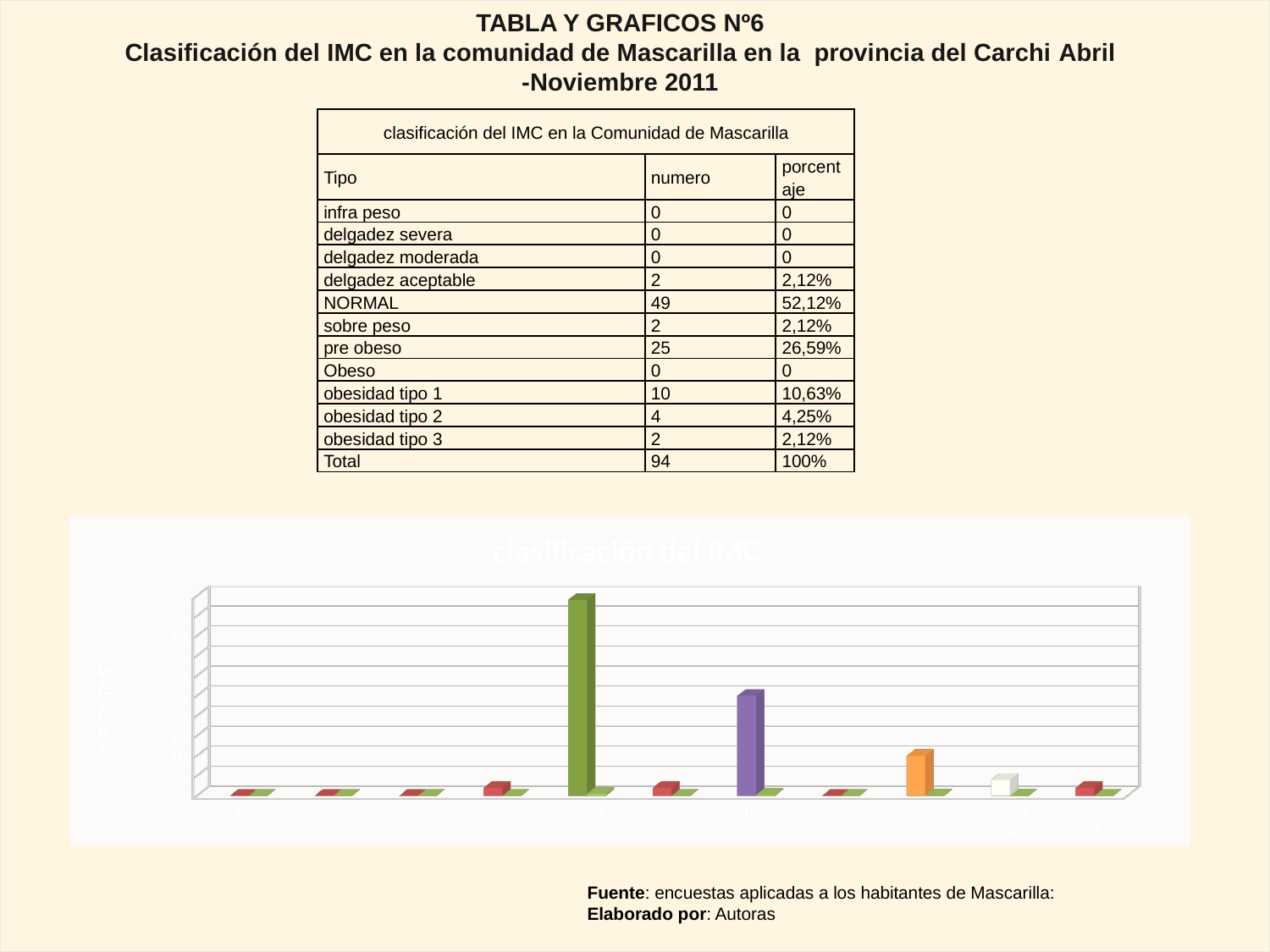
Which bar is taller in the chart, obesidad tipo 1 or obesidad tipo 2? obesidad tipo 1 Do the bars in the chart rise steadily, fall steadily, or fluctuate from left to right along the x axis? fluctuate How many categories are plotted along the x axis of the chart? 11 What colour is the tallest bar in the chart? green Which category has the tallest bar in the chart? NORMAL How many categories in the chart have a bar of essentially zero height? 4 Which bar is taller in the chart, pre obeso or obesidad tipo 1? pre obeso What is the title of the chart? clasificación del IMC What kind of chart is shown on the slide? bar chart Which bar is taller in the chart, NORMAL or pre obeso? NORMAL Which category has the second tallest bar in the chart? pre obeso